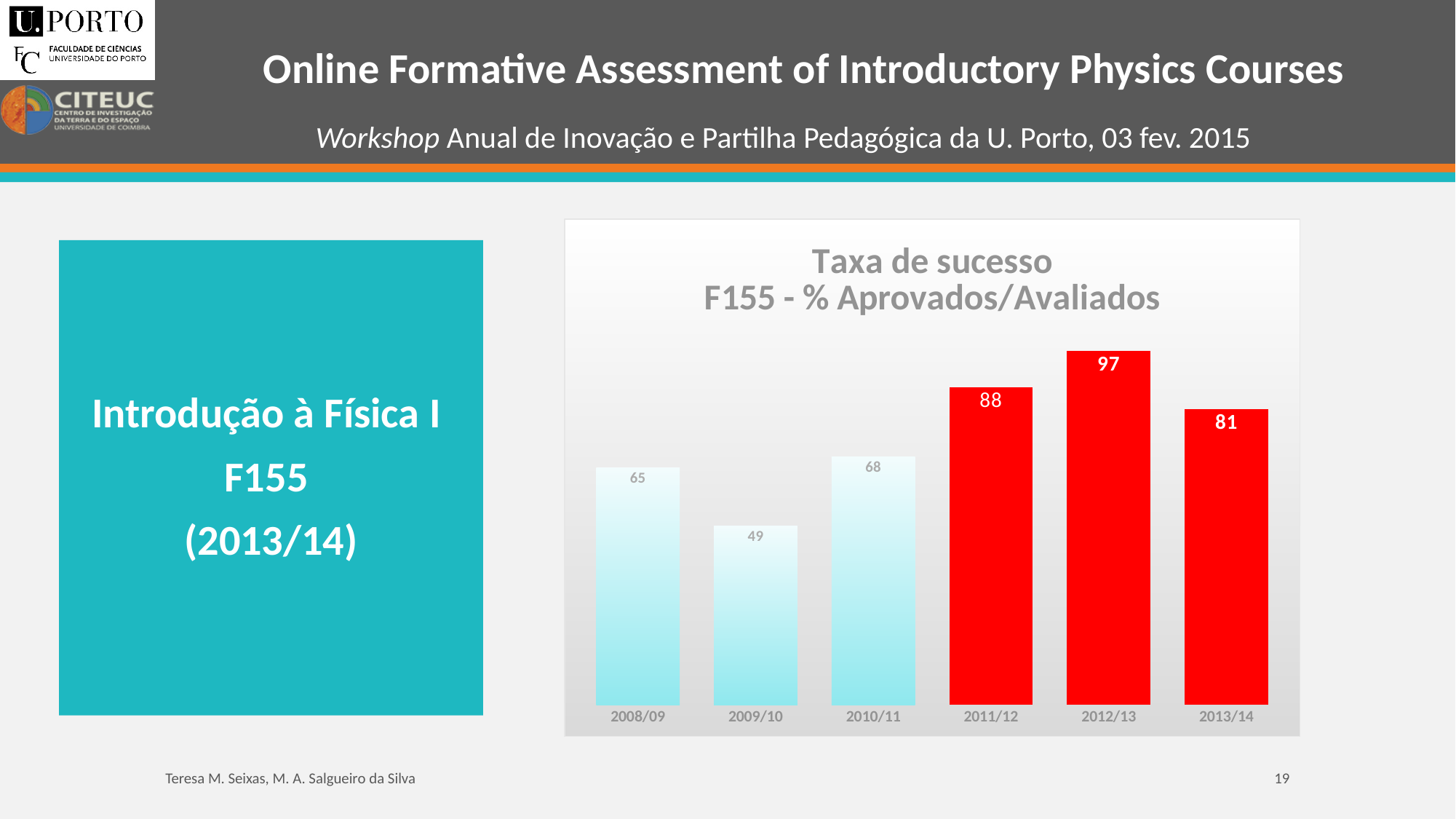
What is the value for 2012/13? 97 What is the difference between the values for 2012/13 and 2013/14? 16 Which year has the highest value? 2012/13 What kind of chart is shown? bar chart Which year has the lowest value? 2009/10 How many years are shown on the x axis? 6 What is the value for 2013/14? 81 What is the title of the chart? Taxa de sucesso F155 - % Aprovados/Avaliados Which is larger, the value for 2008/09 or the value for 2010/11? 2010/11 Do the values rise or fall from 2009/10 to 2012/13? rise What is the value for 2008/09? 65 What is the difference between the values for 2011/12 and 2010/11? 20